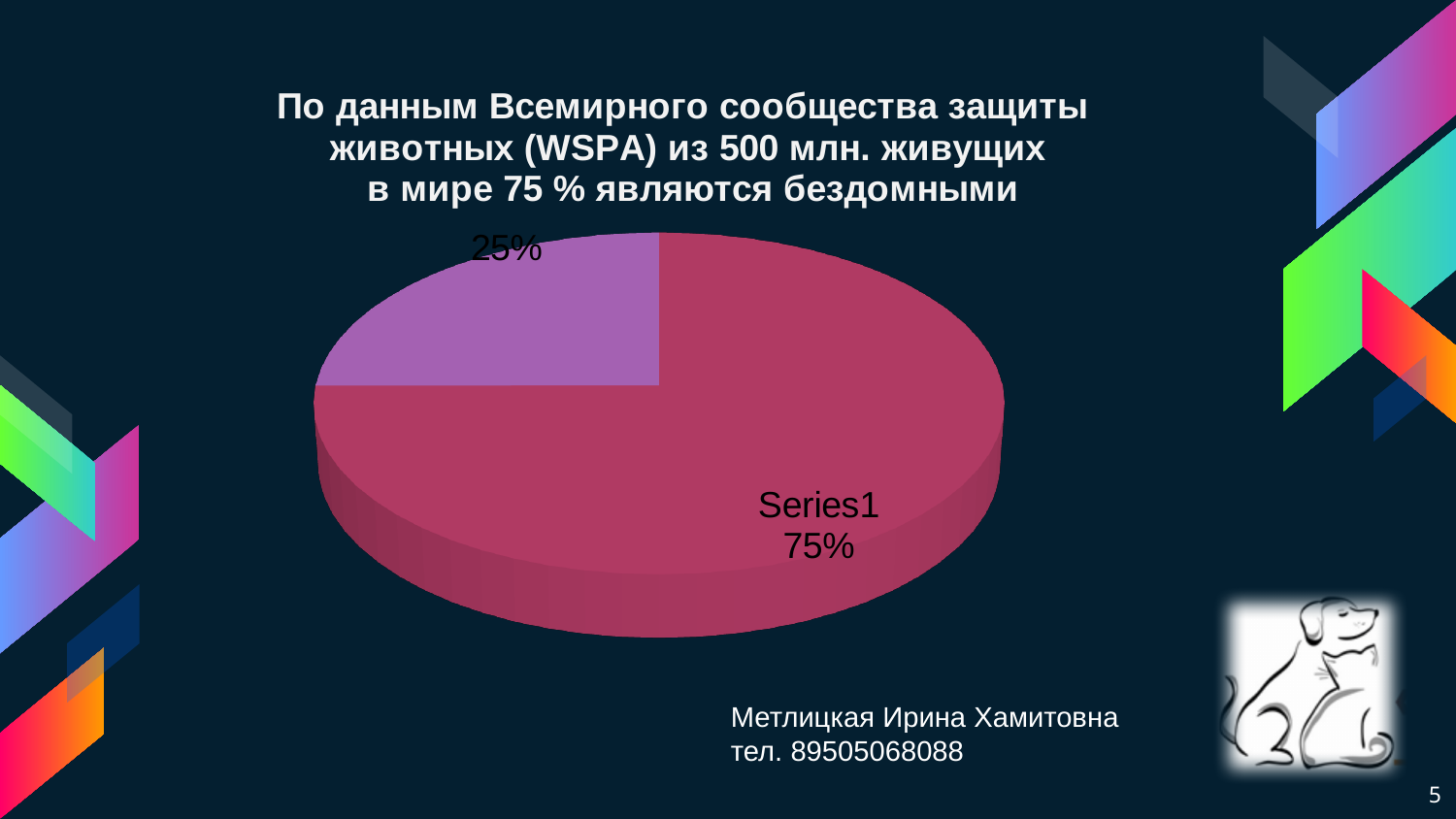
What is the difference in percentage points between the two slices of the pie chart? 50 What percentage is shown on the slice labelled Series1? 75% What colour is the slice labelled Series1? red/pink What share of the pie does the Series1 slice take up? 75% How many slices does the pie chart have? 2 What is the total of the two slice percentages shown on the pie chart? 100% Is the Series1 slice larger or smaller than the purple slice? larger What kind of chart is shown on the slide? pie chart Which slice of the pie chart is the smallest? the purple slice (25%) What percentage is shown on the smaller, purple slice of the pie chart? 25% According to the text above the chart, how many million animals living in the world does the WSPA figure refer to? 500 млн. Which slice of the pie chart is the largest? Series1 (75%)